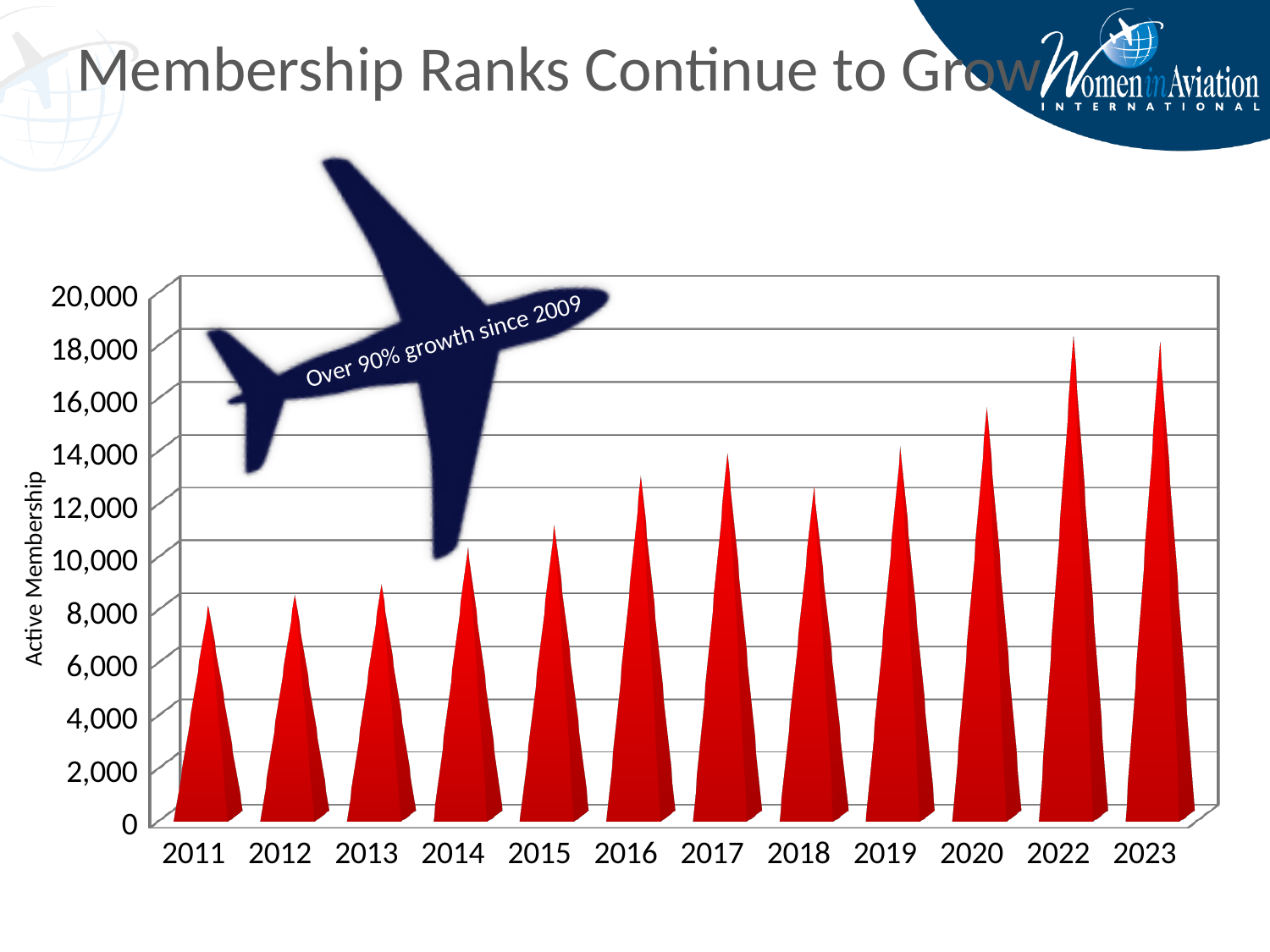
Which year has the larger value, 2015 or 2020? 2020 Is the value for 2020 greater or less than 14,000? greater What kind of chart is shown on the slide? Bar chart Overall, do the membership values rise or fall from 2011 to 2023? Rise Is the value for 2022 greater or less than 16,000? greater Is the value for 2011 greater or less than 10,000? less How many years are shown on the x axis of the chart? 12 Which year has the larger value, 2017 or 2018? 2017 What is the title of the chart's vertical axis? Active Membership What does the text annotation on the chart say? Over 90% growth since 2009